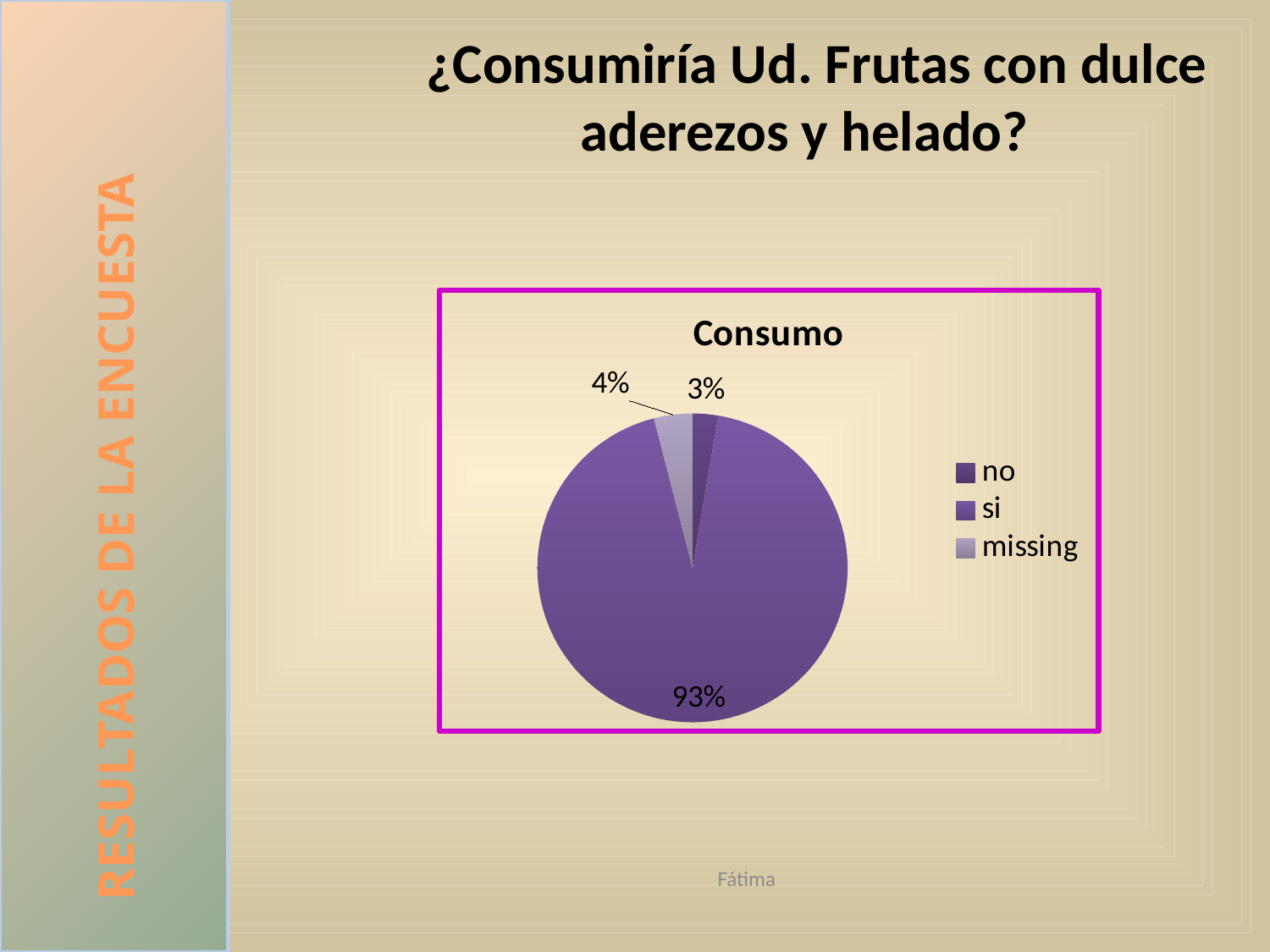
Which is larger, the 'missing' slice or the 'no' slice? missing Which legend entry is listed first? no What is the difference in percentage points between the 'si' slice and the 'missing' slice? 89 How many categories does the legend list? 3 What percentage of the pie does the 'si' slice represent? 93% What is the difference in percentage points between the 'missing' slice and the 'no' slice? 1 Which category has the largest share of the pie? si What type of chart is shown on the slide? pie chart What percentage of the pie does the 'missing' slice represent? 4% Which category has the smallest share of the pie? no What is the title of the chart? Consumo What percentage of the pie does the 'no' slice represent? 3%